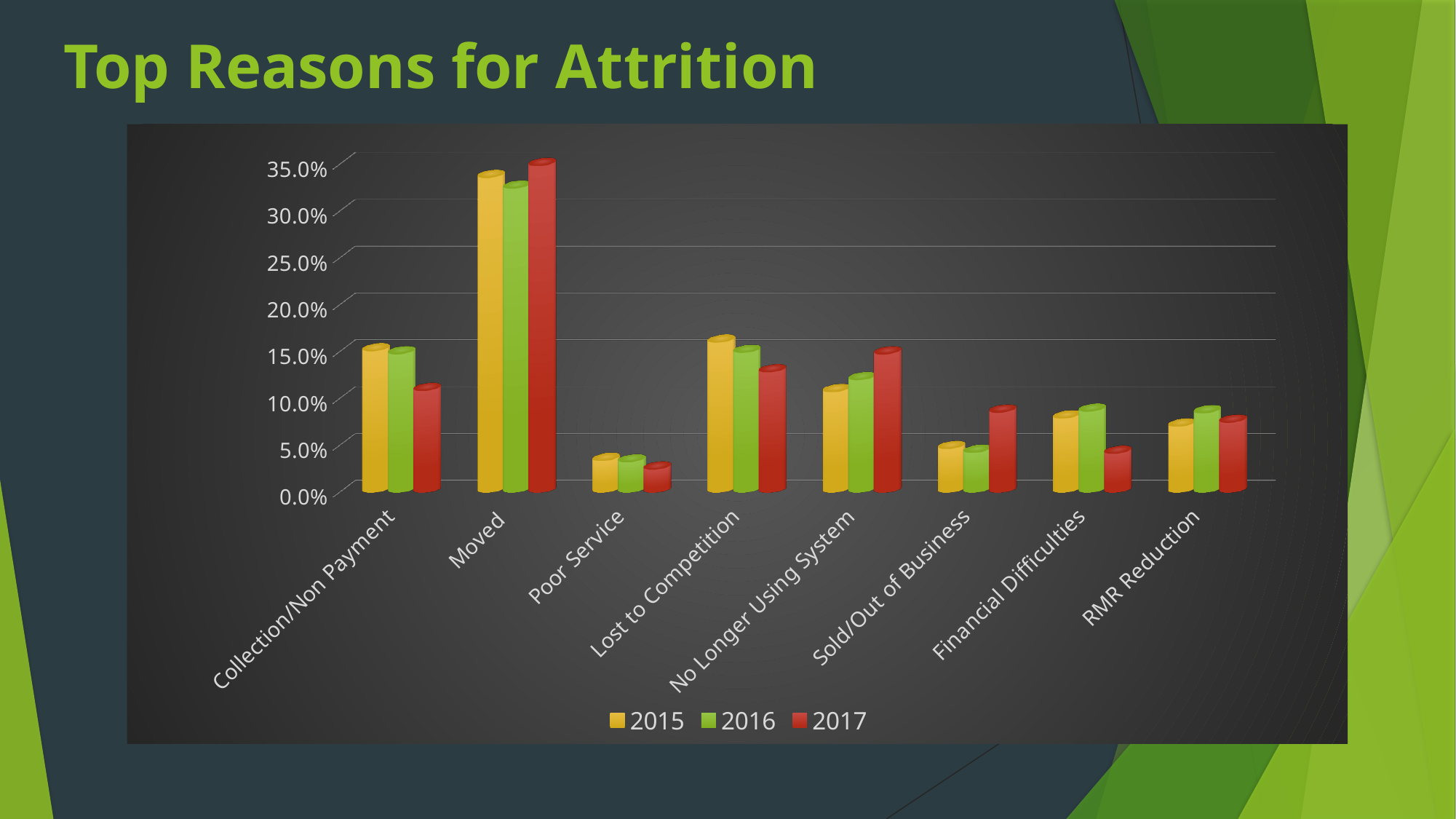
For No Longer Using System, which year has the larger value, 2015 or 2017? 2017 How many series does the legend list? 3 Which category has the lowest value for 2015? Poor Service For Moved, which year has the larger value, 2016 or 2017? 2017 Which colour represents the 2017 series in the legend? Red How many attrition reason categories are shown on the x axis? 8 What kind of chart is shown on the slide? Bar chart Is the 2015 value for Poor Service greater or less than 5.0%? less Which category has the highest value for 2017? Moved For Collection/Non Payment, which year has the larger value, 2015 or 2017? 2015 Is the 2017 value for Moved greater or less than 30.0%? greater Is the 2017 value for Sold/Out of Business greater or less than 5.0%? greater